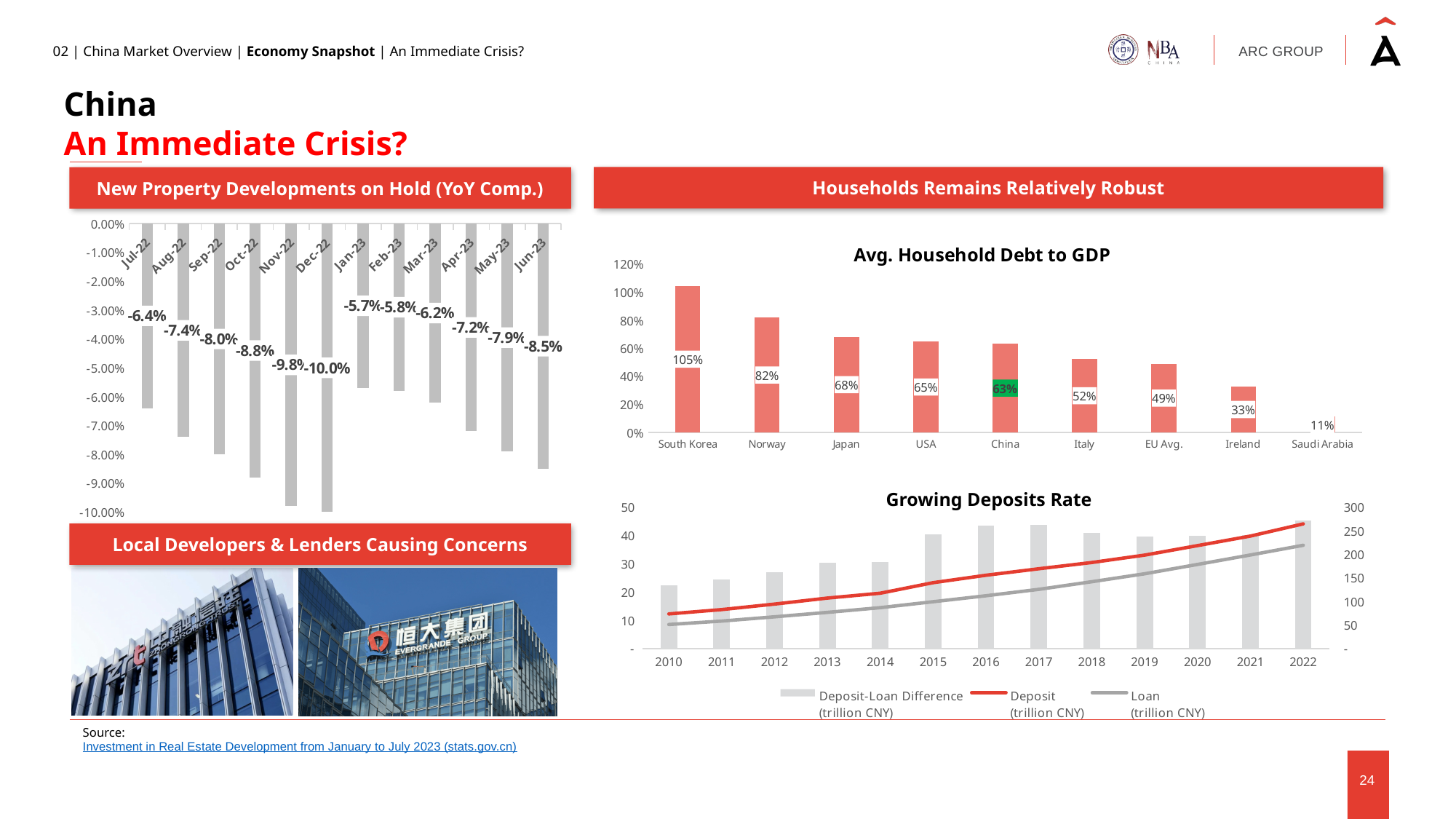
In the 'Avg. Household Debt to GDP' chart, what is the value for China? 63% In the 'Avg. Household Debt to GDP' chart, which is larger, the value for Japan or the value for Italy? Japan In the 'New Property Developments on Hold (YoY Comp.)' chart, what is the difference between the Jun-23 value and the Jul-22 value? 2.1 percentage points In the 'New Property Developments on Hold (YoY Comp.)' chart, what is the value for Dec-22? -10.0% In the 'Growing Deposits Rate' chart, is the Deposit value for 2022 greater or less than 250 on the right axis? greater In the 'Avg. Household Debt to GDP' chart, which country has the highest value? South Korea In the 'Avg. Household Debt to GDP' chart, which country has the lowest value? Saudi Arabia In the 'New Property Developments on Hold (YoY Comp.)' chart, how many months are plotted? 12 In the 'Growing Deposits Rate' chart, how many series does the legend list? 3 In the 'New Property Developments on Hold (YoY Comp.)' chart, which month has the smallest decline (value closest to zero)? Jan-23 In the 'Avg. Household Debt to GDP' chart, how much higher is Norway's value than Ireland's? 49 percentage points In the 'Growing Deposits Rate' chart, does the Deposit line rise or fall from 2010 to 2022? rise